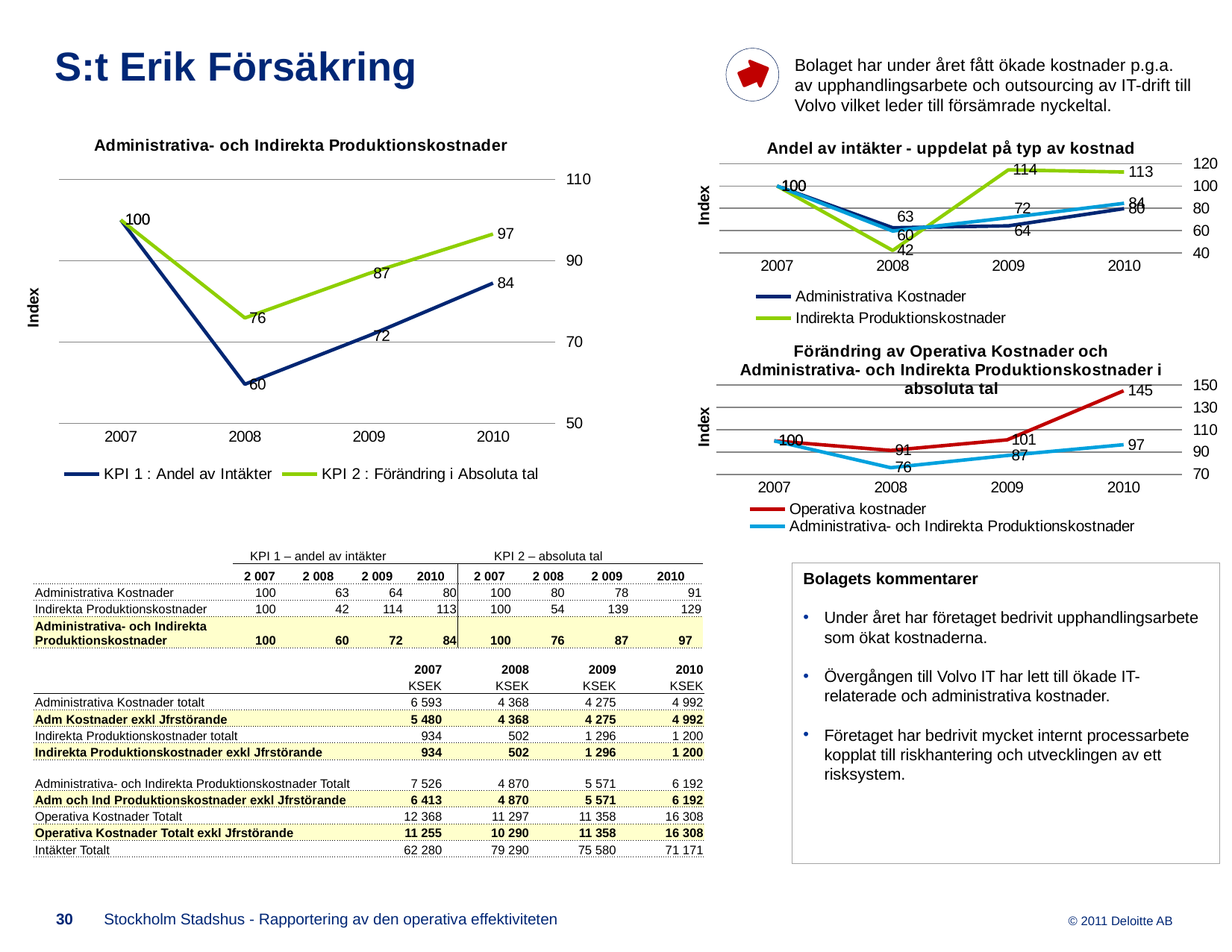
What kind of chart is the chart titled 'Administrativa- och Indirekta Produktionskostnader'? Line chart In the chart titled 'Administrativa- och Indirekta Produktionskostnader', what is the difference between KPI 2 and KPI 1 in 2009? 15 In the chart titled 'Förändring av Operativa Kostnader och Administrativa- och Indirekta Produktionskostnader i absoluta tal', what is the value of Operativa kostnader in 2010? 145 In the chart titled 'Andel av intäkter - uppdelat på typ av kostnad', which series is higher in 2009, Administrativa Kostnader or Indirekta Produktionskostnader? Indirekta Produktionskostnader In the chart titled 'Andel av intäkter - uppdelat på typ av kostnad', what is the value of Administrativa Kostnader in 2010? 80 In the chart titled 'Administrativa- och Indirekta Produktionskostnader', how many series does the legend list? 2 In the chart titled 'Andel av intäkter - uppdelat på typ av kostnad', what is the value of Indirekta Produktionskostnader in 2008? 42 In the chart titled 'Administrativa- och Indirekta Produktionskostnader', in which year is KPI 1 : Andel av Intäkter lowest? 2008 In the chart titled 'Administrativa- och Indirekta Produktionskostnader', what is the value of KPI 1 : Andel av Intäkter in 2008? 60 In the chart titled 'Förändring av Operativa Kostnader och Administrativa- och Indirekta Produktionskostnader i absoluta tal', how many years are shown on the x axis? 4 In the chart titled 'Förändring av Operativa Kostnader och Administrativa- och Indirekta Produktionskostnader i absoluta tal', what is the difference between Operativa kostnader and Administrativa- och Indirekta Produktionskostnader in 2008? 15 In the chart titled 'Administrativa- och Indirekta Produktionskostnader', what is the value of KPI 2 : Förändring i Absoluta tal in 2010? 97